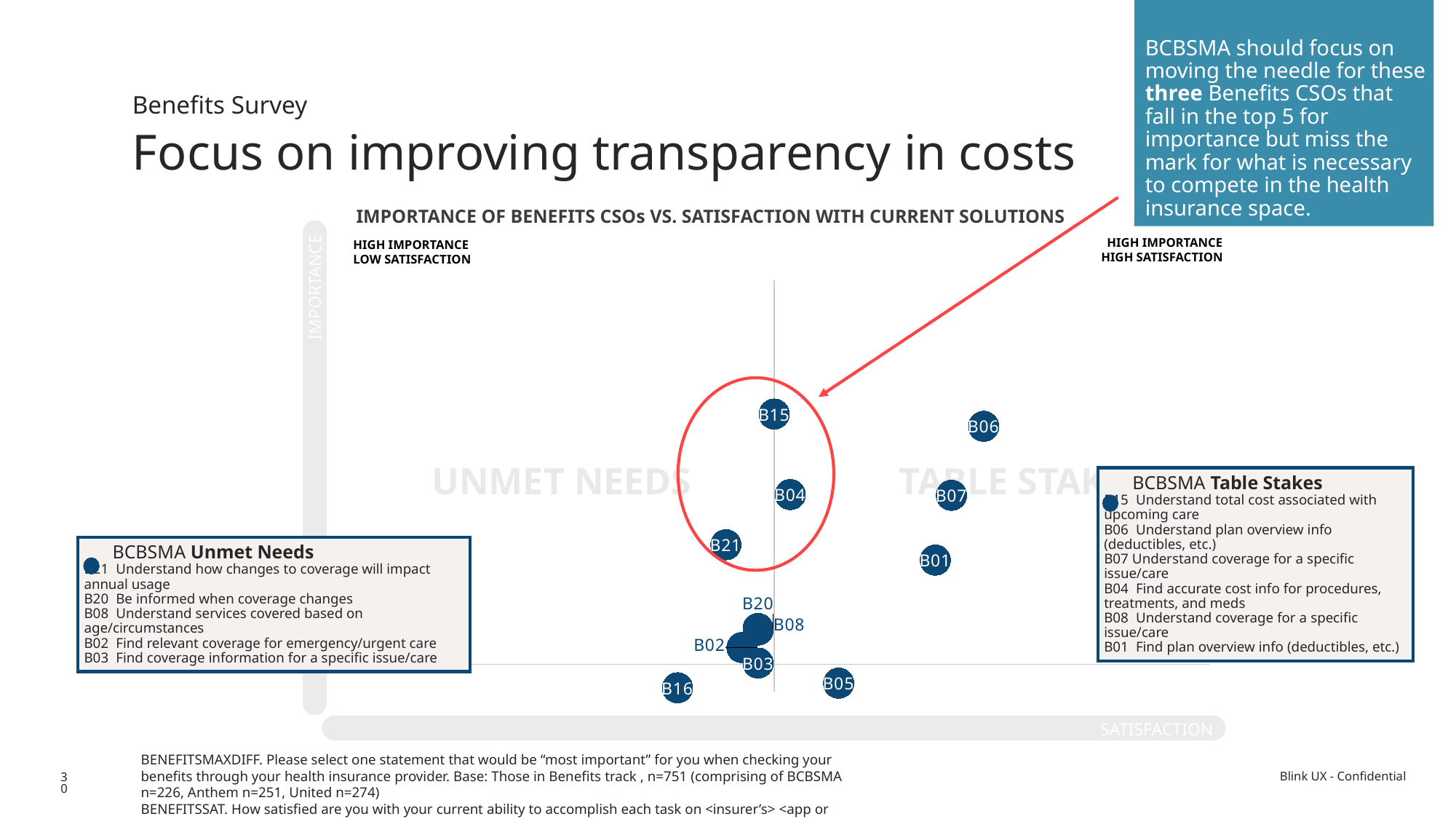
Which has higher importance on the chart, B01 or B05? B01 Which data point on the chart has higher importance, B20 or B16? B20 How many labeled data points are plotted on the chart? 12 Which has higher satisfaction on the chart, B06 or B21? B06 What is the title of the chart? IMPORTANCE OF BENEFITS CSOs VS. SATISFACTION WITH CURRENT SOLUTIONS What label is shown on the vertical axis of the chart? IMPORTANCE Which data point has the highest satisfaction (is furthest to the right) on the chart? B06 Which data point has the lowest satisfaction (is furthest to the left) on the chart? B16 How many data points are enclosed by the red circle on the chart? 3 What kind of chart is shown on the slide? Scatter chart